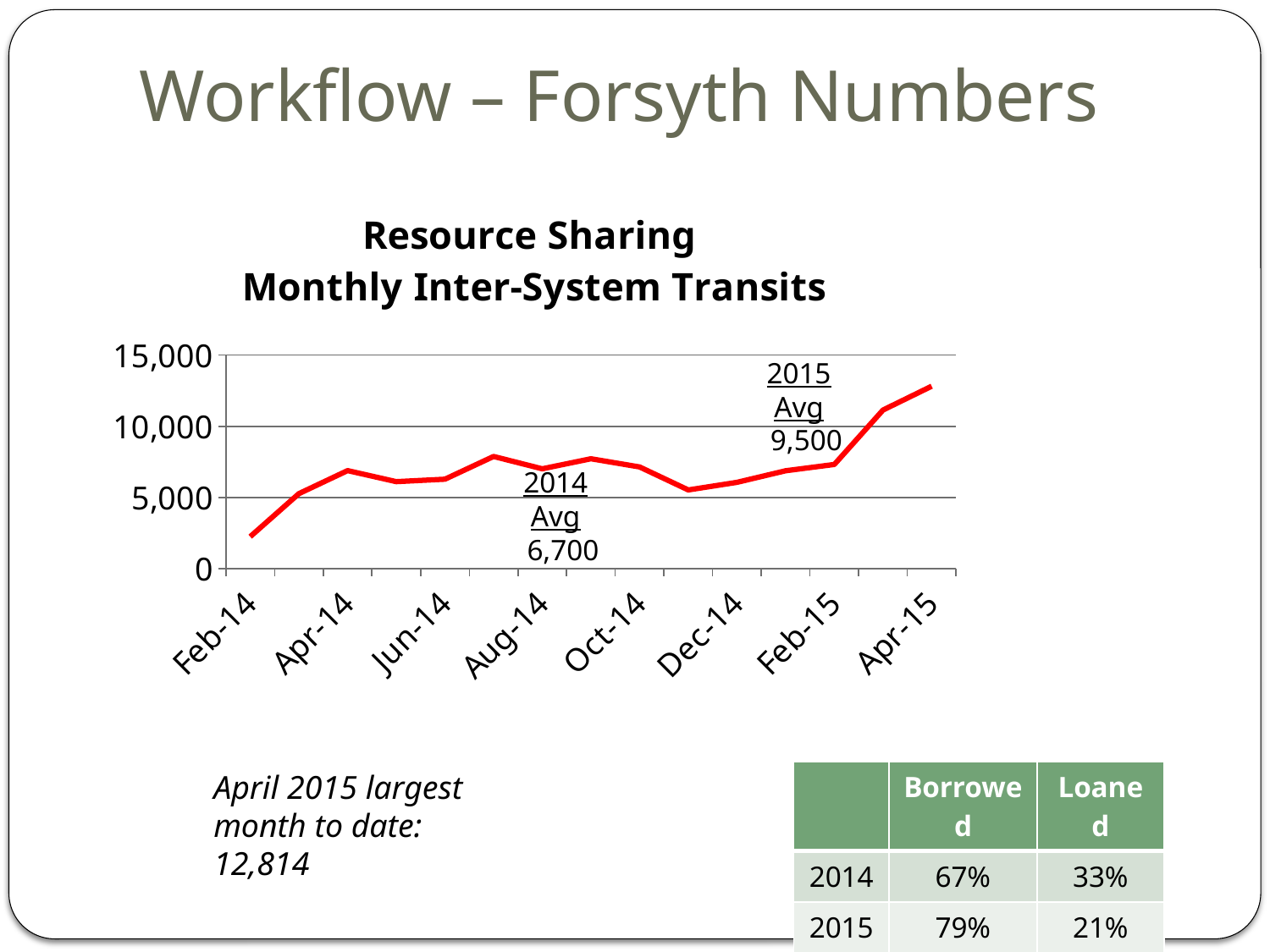
Which is larger, the value for Apr-15 or the value for Oct-14? Apr-15 Which month has the highest number of monthly inter-system transits? Apr-15 Is the value for Apr-15 greater or less than 10,000? greater What kind of chart is shown on the slide? line chart What is the difference between the 2015 average and the 2014 average shown on the chart? 2,800 Do the values rise or fall from Dec-14 to Apr-15? rise What is the 2015 average shown on the chart? 9,500 What is the title of the chart? Resource Sharing Monthly Inter-System Transits What is the 2014 average shown on the chart? 6,700 What is the value of monthly inter-system transits for April 2015? 12,814 Is the value for Feb-14 greater or less than 5,000? less Which month has the lowest number of monthly inter-system transits? Feb-14